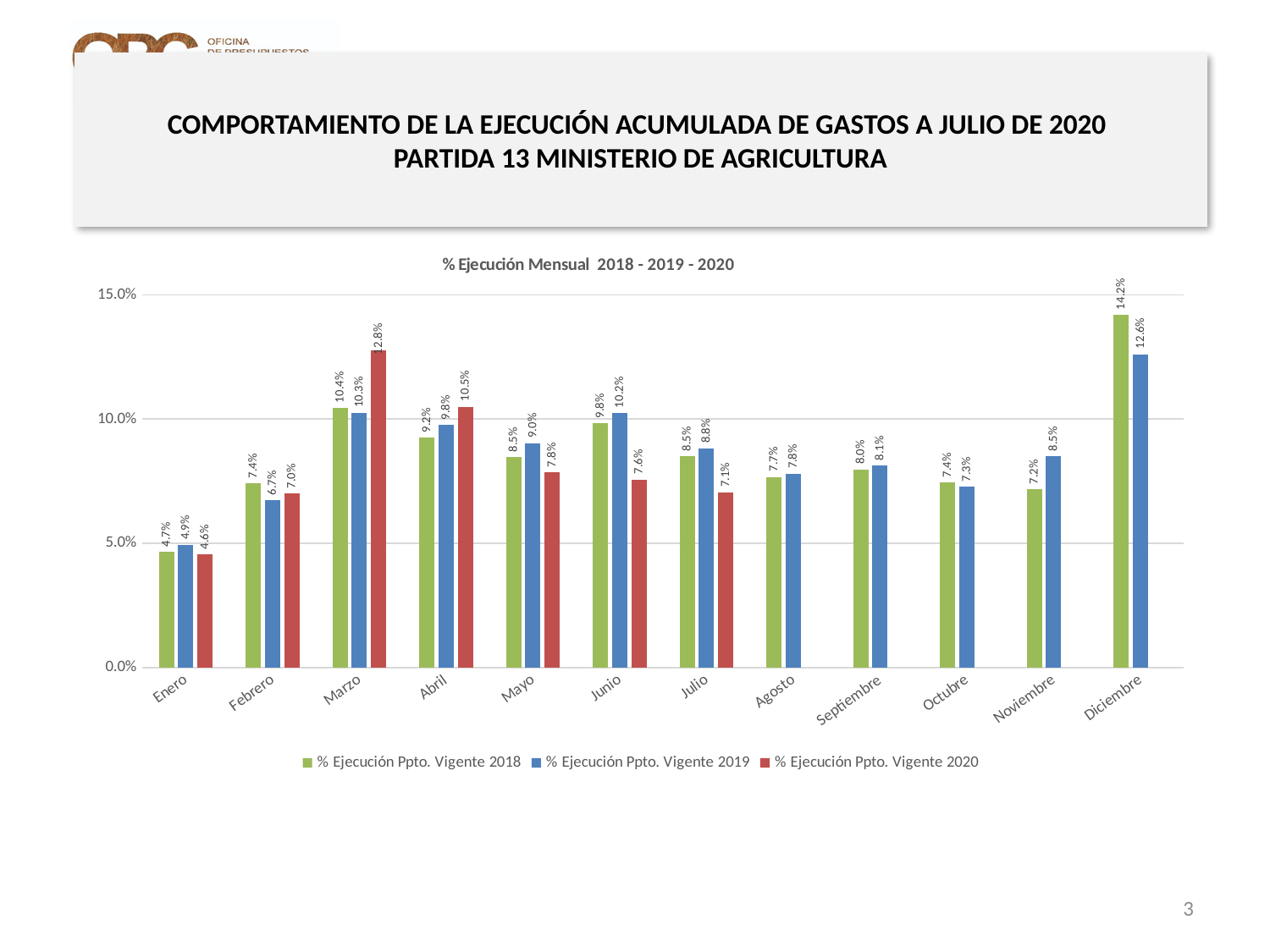
How many series does the legend list? 3 What is the title of the chart? % Ejecución Mensual 2018 - 2019 - 2020 Which month has the lowest value for % Ejecución Ppto. Vigente 2019? Enero Is the value for % Ejecución Ppto. Vigente 2019 in Diciembre greater or less than 10.0%? greater What kind of chart is shown? Bar chart What is the value for % Ejecución Ppto. Vigente 2019 in Junio? 10.2% Which month has the highest value for % Ejecución Ppto. Vigente 2020? Marzo How many months are shown on the x axis? 12 Which is larger in Julio: the 2019 value or the 2020 value? 2019 value (8.8%) What is the value for % Ejecución Ppto. Vigente 2018 in Diciembre? 14.2% What is the difference between the 2020 and 2018 values in Marzo? 2.4% What is the value for % Ejecución Ppto. Vigente 2020 in Marzo? 12.8%